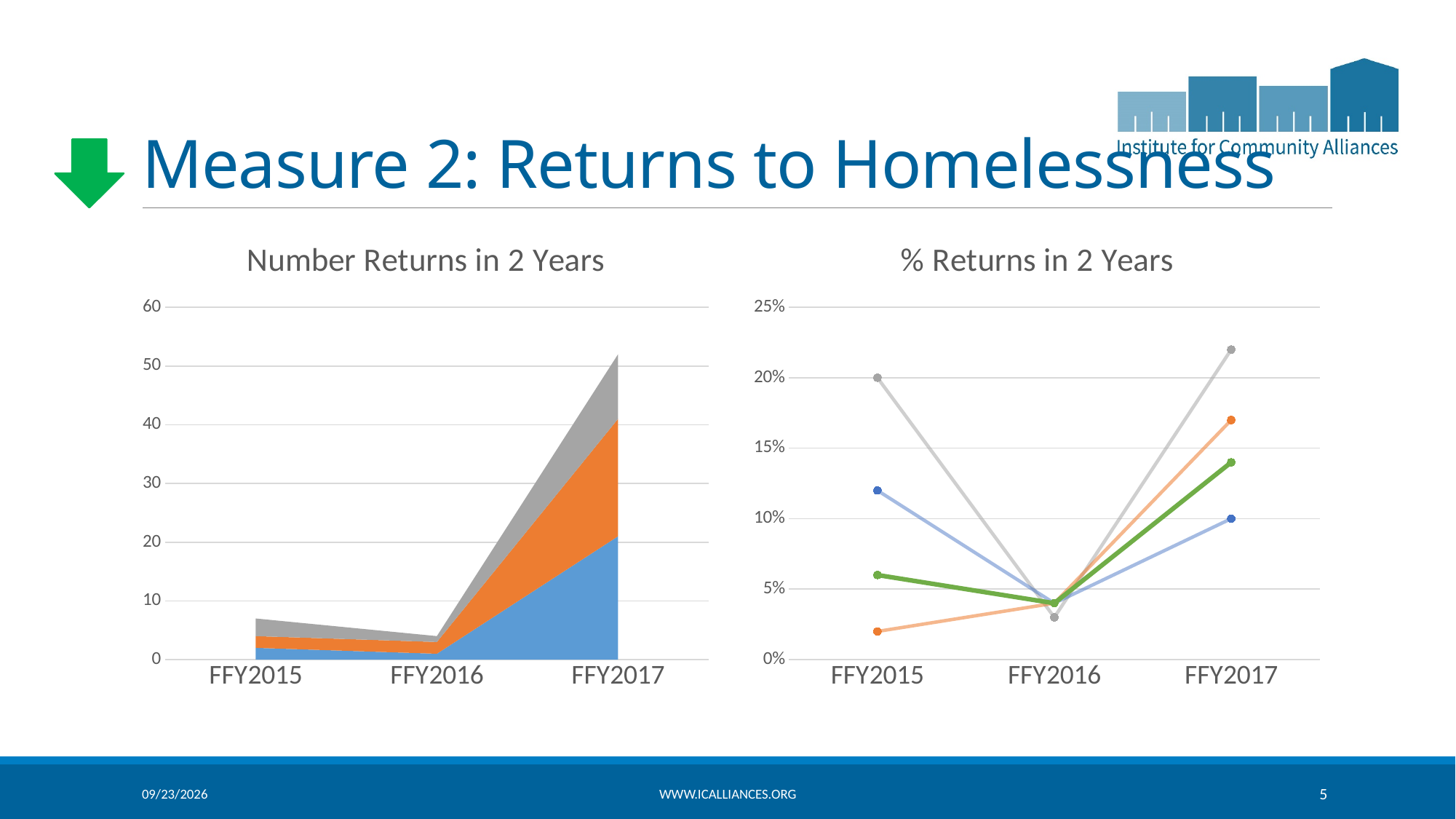
In the 'Number Returns in 2 Years' chart, is the total for FFY2017 greater or less than 40? greater In the 'Number Returns in 2 Years' chart, which year has the highest total number of returns? FFY2017 In the 'Number Returns in 2 Years' chart, is the total for FFY2015 greater or less than 10? less In the '% Returns in 2 Years' chart, how many lines are plotted? 4 In the 'Number Returns in 2 Years' chart, do the totals rise or fall from FFY2016 to FFY2017? rise In the '% Returns in 2 Years' chart, what is the highest value plotted at FFY2015? 20% In the '% Returns in 2 Years' chart, is the highest value at FFY2017 greater or less than 20%? greater In the 'Number Returns in 2 Years' chart, how many stacked series are shown? 3 In the 'Number Returns in 2 Years' chart, which year has the lowest total number of returns? FFY2016 What kind of chart is the 'Number Returns in 2 Years' chart on the left? area chart In the 'Number Returns in 2 Years' chart, how many fiscal years are shown on the x axis? 3 What kind of chart is the '% Returns in 2 Years' chart on the right? line chart